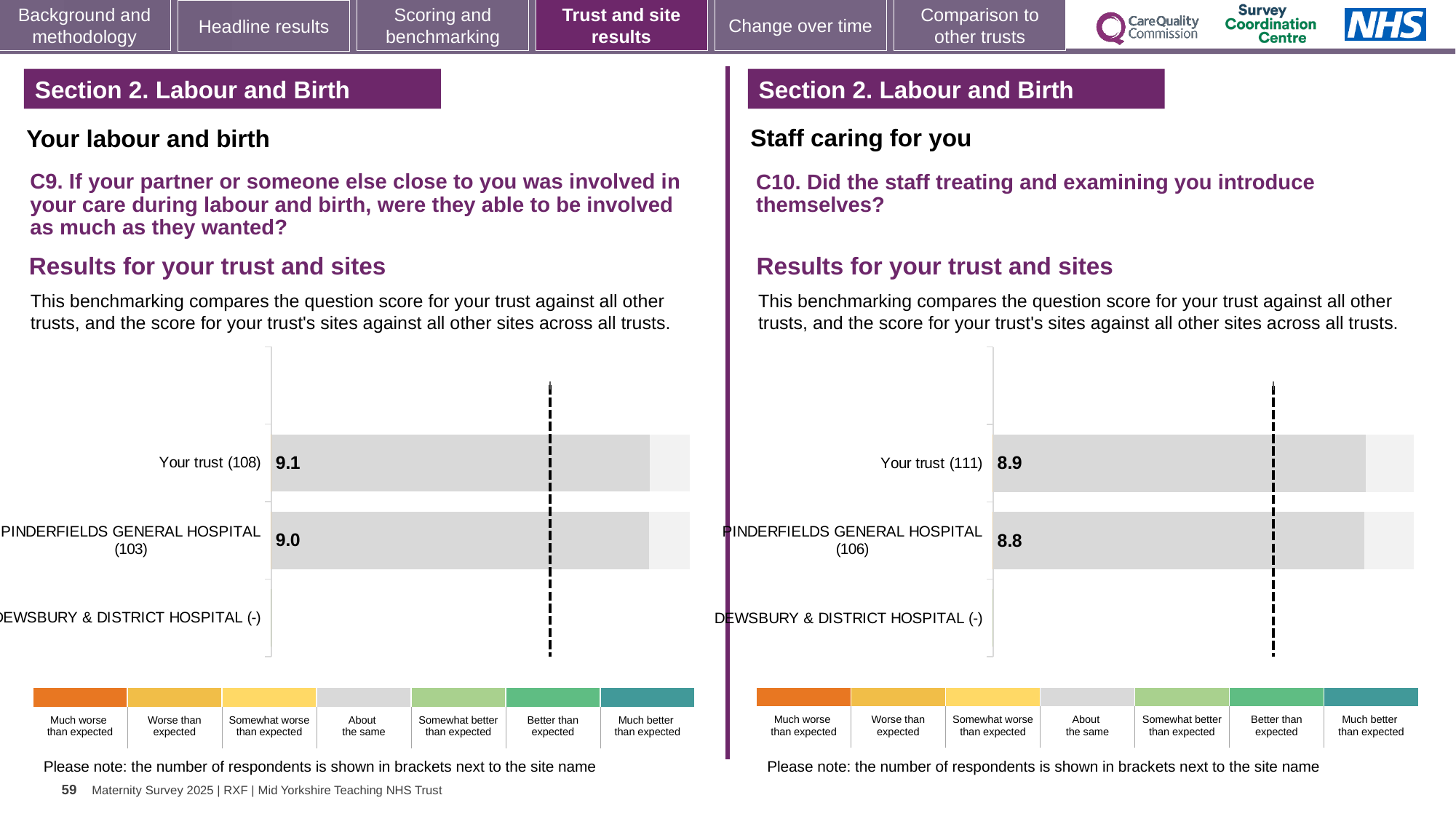
In the right chart (C10), what is the score for Your trust (111)? 8.9 In the right chart (C10), what is the score for PINDERFIELDS GENERAL HOSPITAL (106)? 8.8 In the right chart (C10), which has the higher score: Your trust or PINDERFIELDS GENERAL HOSPITAL? Your trust In the left chart (C9), what is the difference between the score for Your trust and the score for PINDERFIELDS GENERAL HOSPITAL? 0.1 In the left chart (C9), what is the score for Your trust (108)? 9.1 How many categories are listed on the vertical axis of the left chart (C9)? 3 In the right chart (C10), how many respondents are shown in brackets for Your trust? 111 In the left chart (C9), which site has no score bar shown? DEWSBURY & DISTRICT HOSPITAL (-) What kind of chart is used on the right side of the slide (C10)? Bar chart In the left chart (C9), what is the score for PINDERFIELDS GENERAL HOSPITAL (103)? 9.0 In the left chart (C9), which has the lower score: Your trust or PINDERFIELDS GENERAL HOSPITAL? PINDERFIELDS GENERAL HOSPITAL What is the difference between the Your trust score in the left chart (C9) and the Your trust score in the right chart (C10)? 0.2